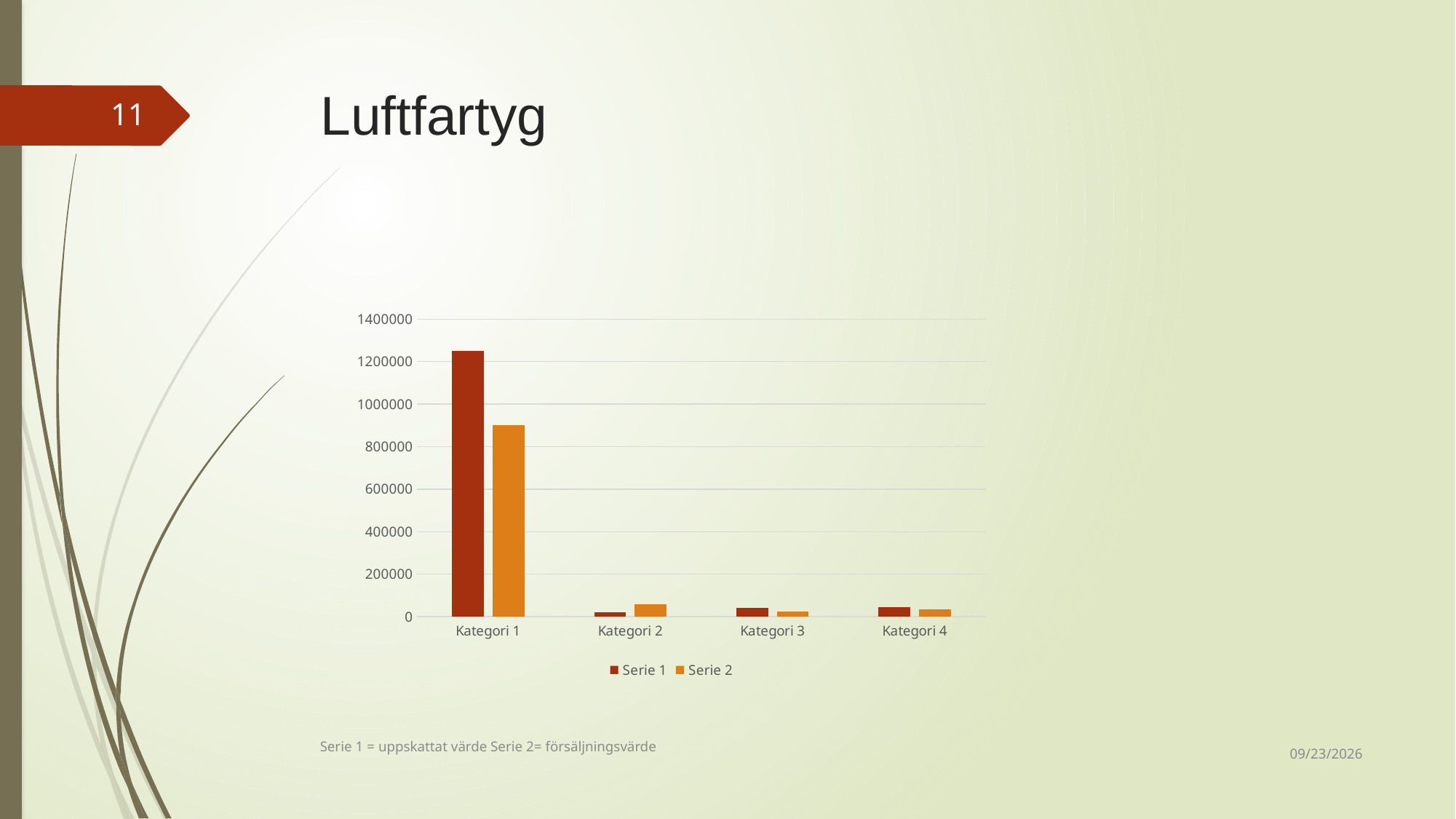
Which category has the highest Serie 1 value? Kategori 1 What is the title of the slide containing the chart? Luftfartyg Is the Serie 2 value for Kategori 1 greater or less than 1000000? less Which category has the highest Serie 2 value? Kategori 1 Is the Serie 1 value for Kategori 1 greater or less than 1200000? greater Which category has the lowest Serie 1 value? Kategori 2 What kind of chart is shown on the slide? bar chart Is the Serie 2 value for Kategori 2 greater or less than 200000? less For Kategori 2, which series has the larger value, Serie 1 or Serie 2? Serie 2 How many series does the chart legend list? 2 For Kategori 1, which series has the larger value, Serie 1 or Serie 2? Serie 1 How many categories are shown on the x axis of the chart? 4